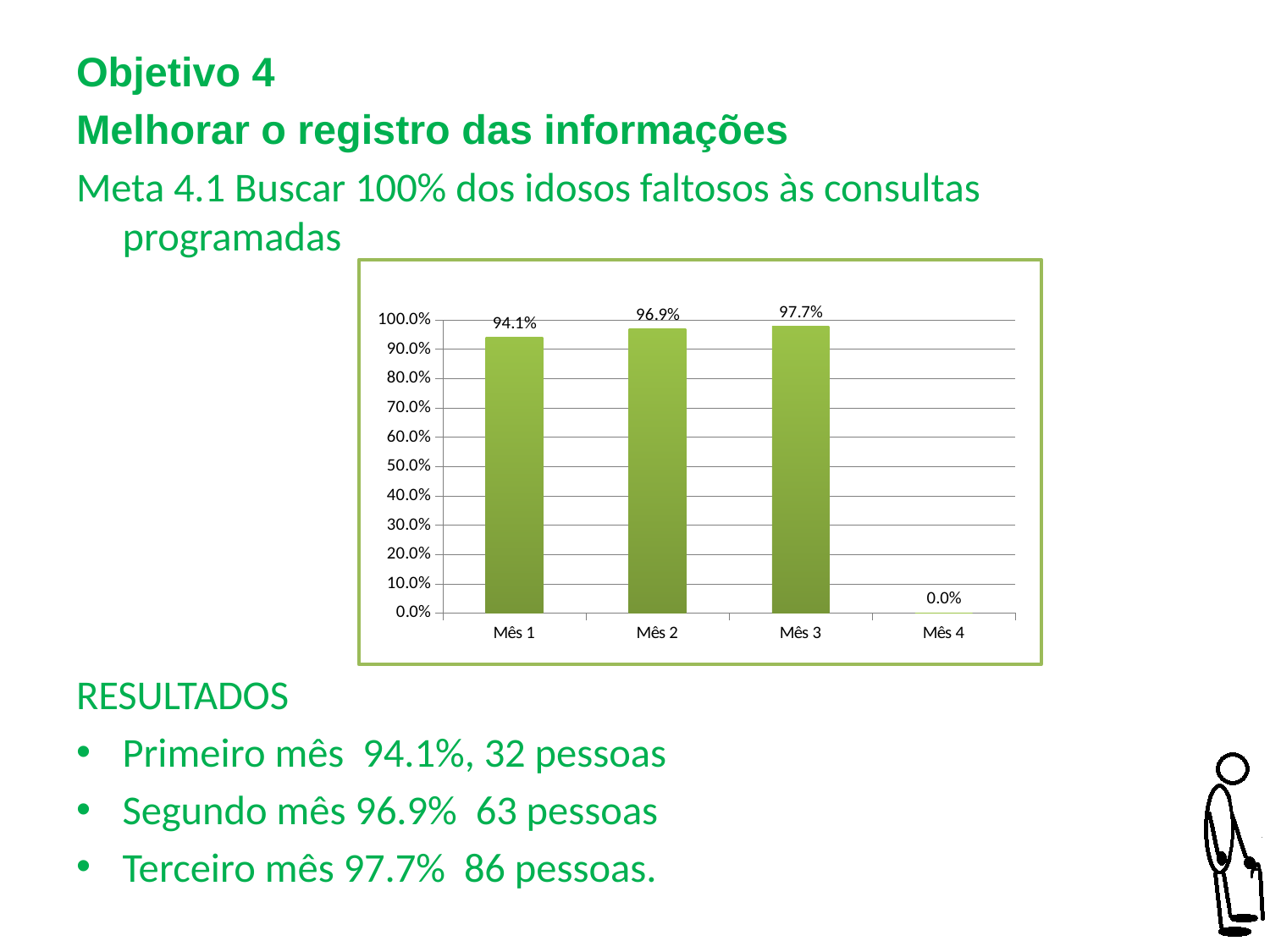
What is the value for Mês 4? 0.0% Do the values rise or fall from Mês 1 to Mês 3? rise Which is larger, the value for Mês 1 or the value for Mês 2? Mês 2 What is the value for Mês 3? 97.7% What kind of chart is shown on the slide? bar chart How many categories are shown on the x axis? 4 Which category has the highest value? Mês 3 Which category has the lowest value? Mês 4 Is the value for Mês 1 greater or less than 90.0%? greater What is the value for Mês 1? 94.1% What is the value for Mês 2? 96.9% What is the difference between the values for Mês 3 and Mês 1? 3.6%